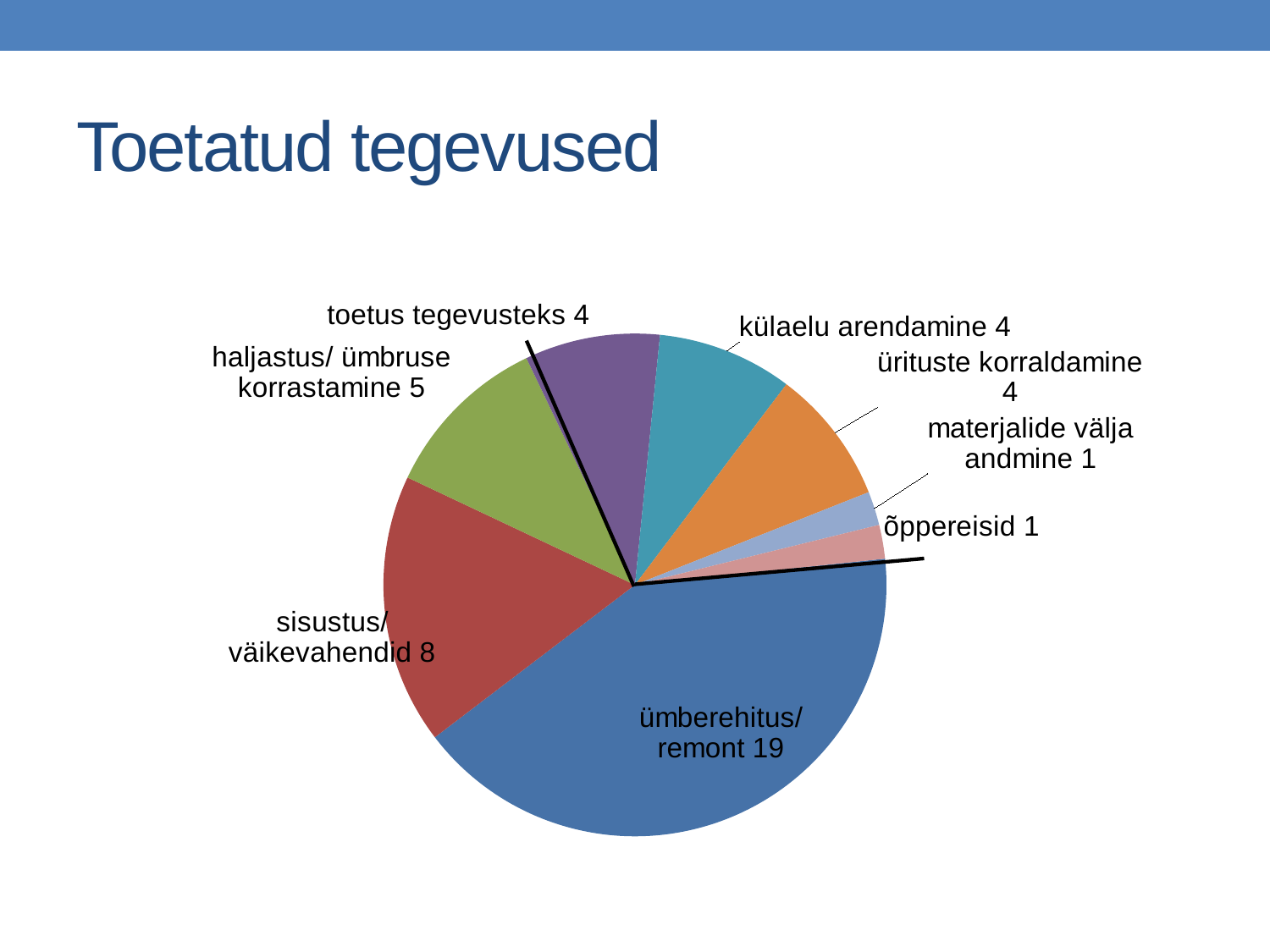
What is the title of the slide containing the chart? Toetatud tegevused What is the value for sisustus/ väikevahendid? 8 What is the difference between the values for ümberehitus/ remont and sisustus/ väikevahendid? 11 What is the value for ümberehitus/ remont? 19 What is the value for külaelu arendamine? 4 What is the difference between the values for haljastus/ ümbruse korrastamine and ürituste korraldamine? 1 What kind of chart is shown on the slide? pie chart Which is larger, the value for sisustus/ väikevahendid or the value for haljastus/ ümbruse korrastamine? sisustus/ väikevahendid What is the value for õppereisid? 1 Which is larger, the value for toetus tegevusteks or the value for materjalide välja andmine? toetus tegevusteks What is the value for haljastus/ ümbruse korrastamine? 5 Which category has the largest slice of the pie? ümberehitus/ remont